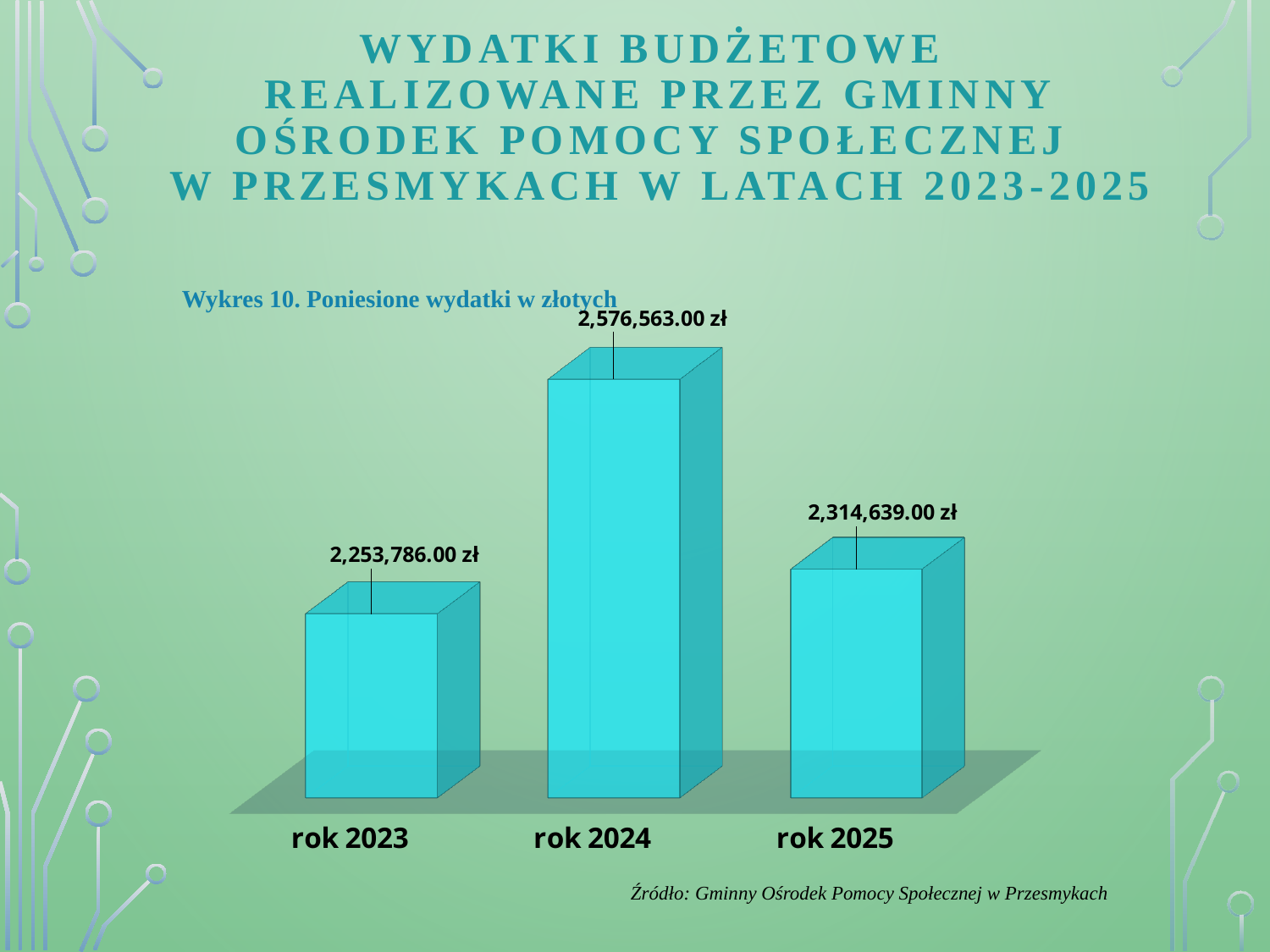
Which year has the lowest expenditure? rok 2023 What is the difference between the values for rok 2025 and rok 2023? 60,853.00 zł What is the title of the chart (Wykres 10)? Poniesione wydatki w złotych What is the value for rok 2024? 2,576,563.00 zł How many years (categories) are shown in the chart? 3 What kind of chart is shown on the slide? bar chart What is the value for rok 2025? 2,314,639.00 zł What is the difference between the values for rok 2024 and rok 2023? 322,777.00 zł Which is larger, the value for rok 2025 or the value for rok 2023? rok 2025 Which year has the highest expenditure? rok 2024 What is the value for rok 2023? 2,253,786.00 zł What is the difference between the values for rok 2024 and rok 2025? 261,924.00 zł